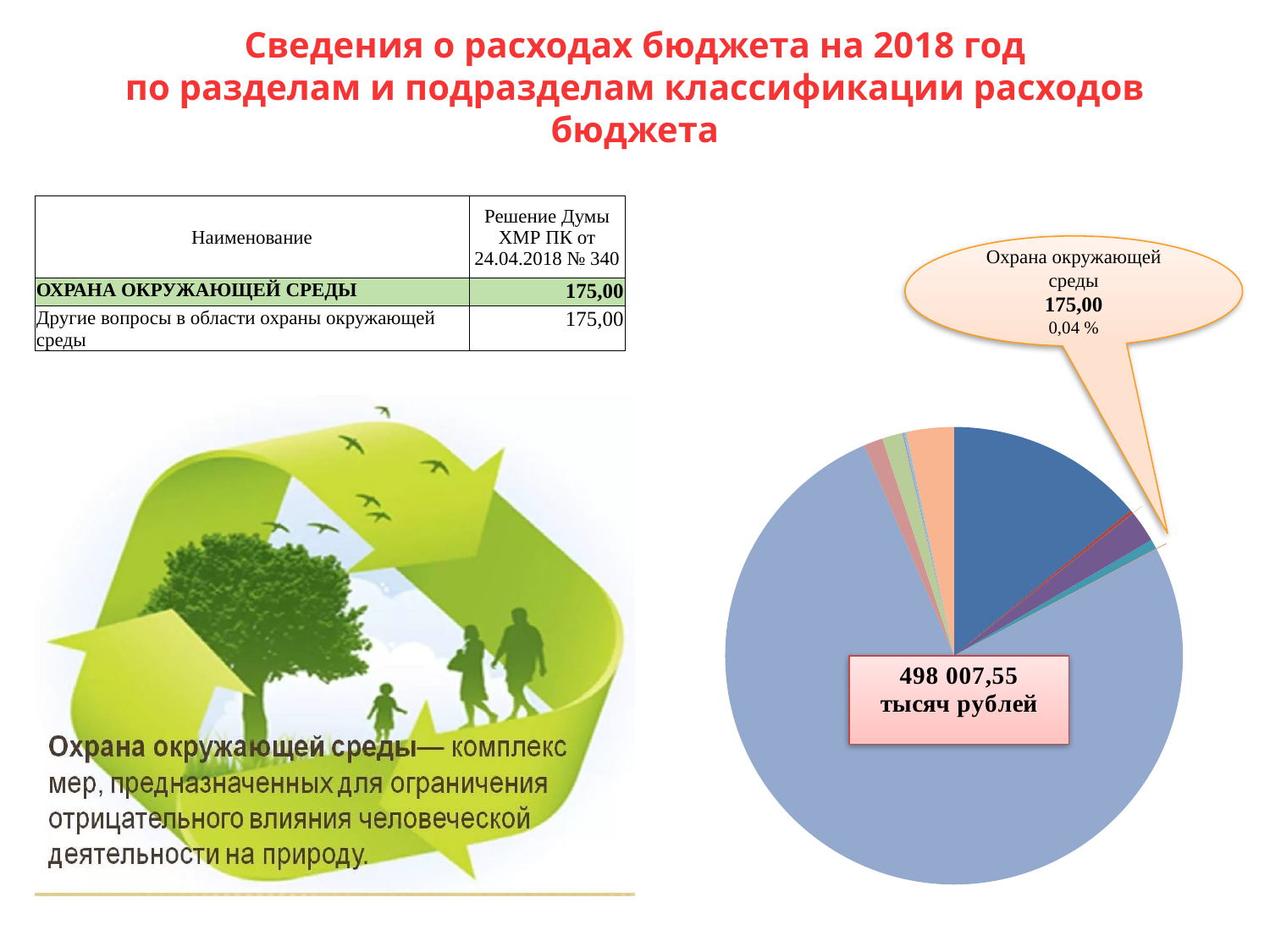
What total amount is printed in the box on the pie chart? 498 007,55 тысяч рублей According to the callout on the pie chart, what share of the pie does Охрана окружающей среды represent? 0,04 % Does the pie chart display a legend listing its categories? No According to the callout on the pie chart, what is the value for Охрана окружающей среды? 175,00 Is the slice for Охрана окружающей среды larger or smaller than half of the pie? smaller Which category is named in the callout pointing to a slice of the pie chart? Охрана окружающей среды What kind of chart is shown on the right side of the slide? pie chart